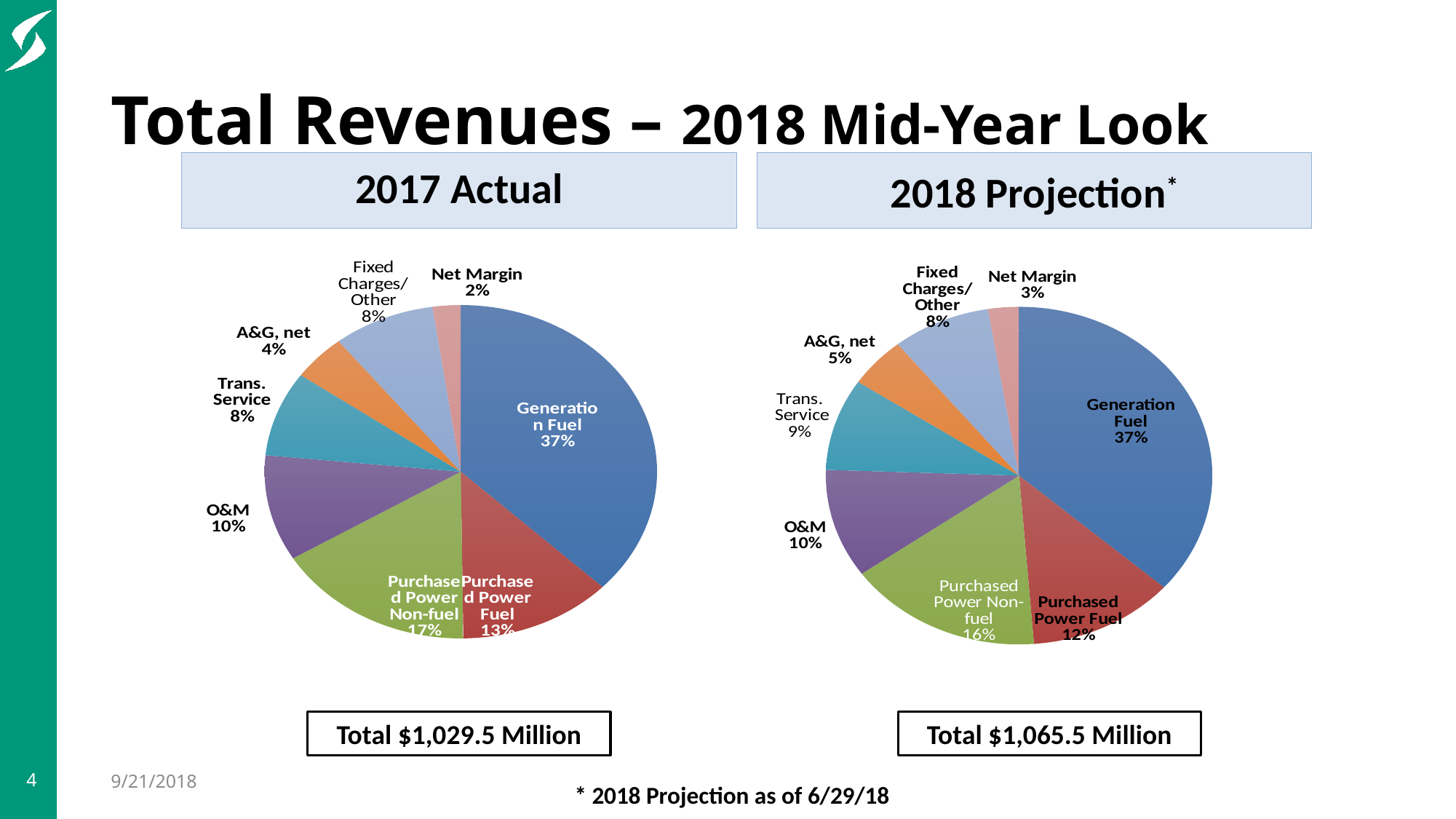
In the 2017 Actual pie chart, which category has the largest slice? Generation Fuel In the 2017 Actual pie chart, what is the difference between the Purchased Power Non-fuel share and the Purchased Power Fuel share? 4% In the 2018 Projection pie chart, which is larger: O&M or A&G, net? O&M In the 2018 Projection pie chart, which category has the smallest slice? Net Margin What total is shown below the 2017 Actual pie chart? Total $1,029.5 Million What total is shown below the 2018 Projection pie chart? Total $1,065.5 Million What type of chart is used for the 2018 Projection? Pie chart How many slices does the 2017 Actual pie chart have? 8 In the 2018 Projection pie chart, what is the share for Trans. Service? 9% In the 2017 Actual pie chart, what is the share for Net Margin? 2% In the 2017 Actual pie chart, what share does Generation Fuel have? 37% In the 2018 Projection pie chart, what share does Purchased Power Fuel have? 12%